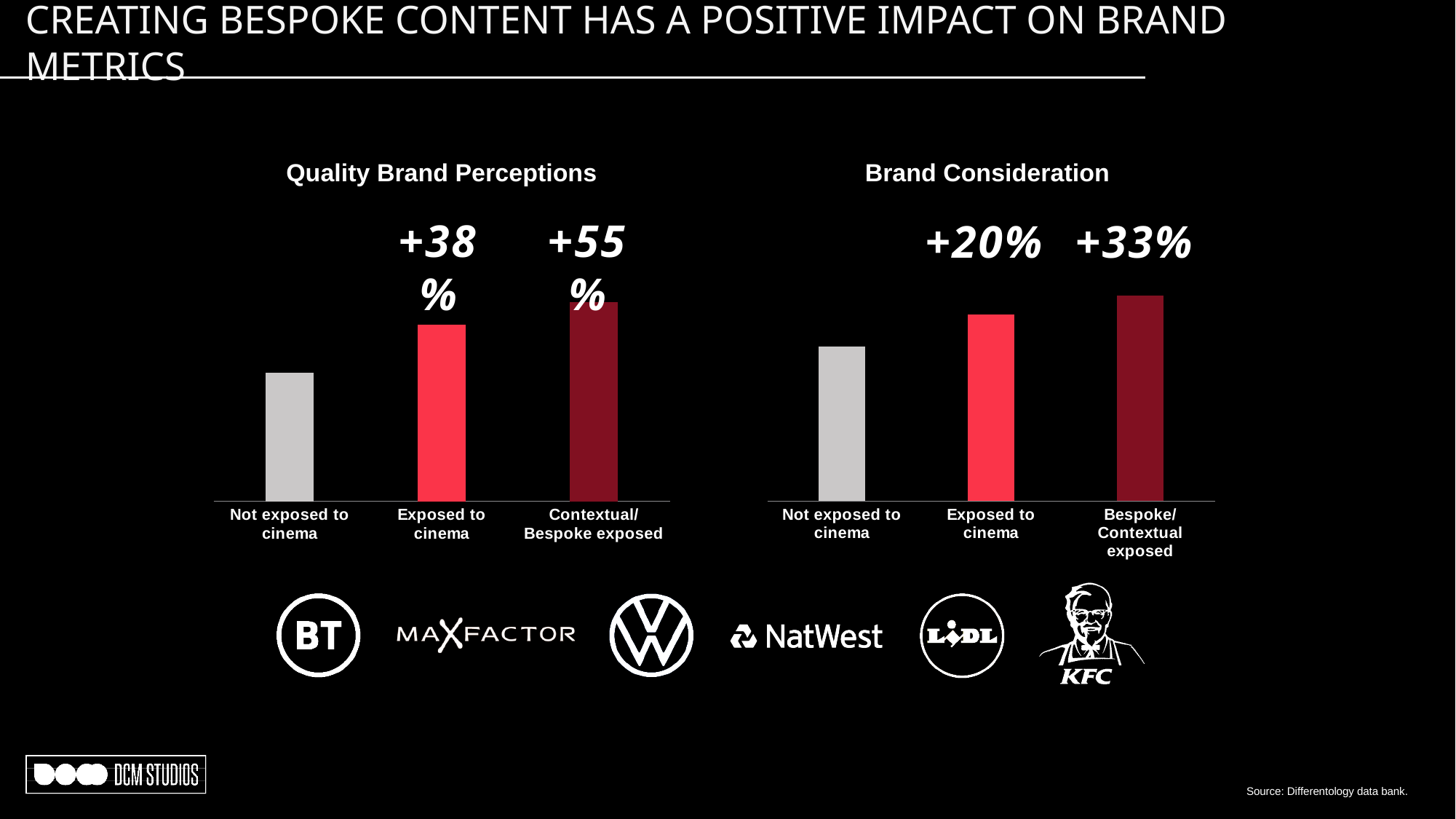
In the Quality Brand Perceptions chart, what uplift label is printed above the 'Exposed to cinema' bar? +38% Do the bars in the Quality Brand Perceptions chart rise or fall from left to right? rise In the Quality Brand Perceptions chart, which category has the highest bar? Contextual/Bespoke exposed In the Quality Brand Perceptions chart, which category has the lowest bar? Not exposed to cinema In the Brand Consideration chart, what uplift label is printed above the 'Exposed to cinema' bar? +20% In the Brand Consideration chart, is the bar for 'Exposed to cinema' taller or shorter than the bar for 'Not exposed to cinema'? taller What kind of chart is the Quality Brand Perceptions chart? bar chart In the Brand Consideration chart, what uplift label is printed above the 'Bespoke/Contextual exposed' bar? +33% How many categories are shown in the Brand Consideration chart? 3 In the Brand Consideration chart, which category has the highest bar? Bespoke/Contextual exposed In the Quality Brand Perceptions chart, what uplift label is printed above the 'Contextual/Bespoke exposed' bar? +55% In the Brand Consideration chart, which category has the lowest bar? Not exposed to cinema